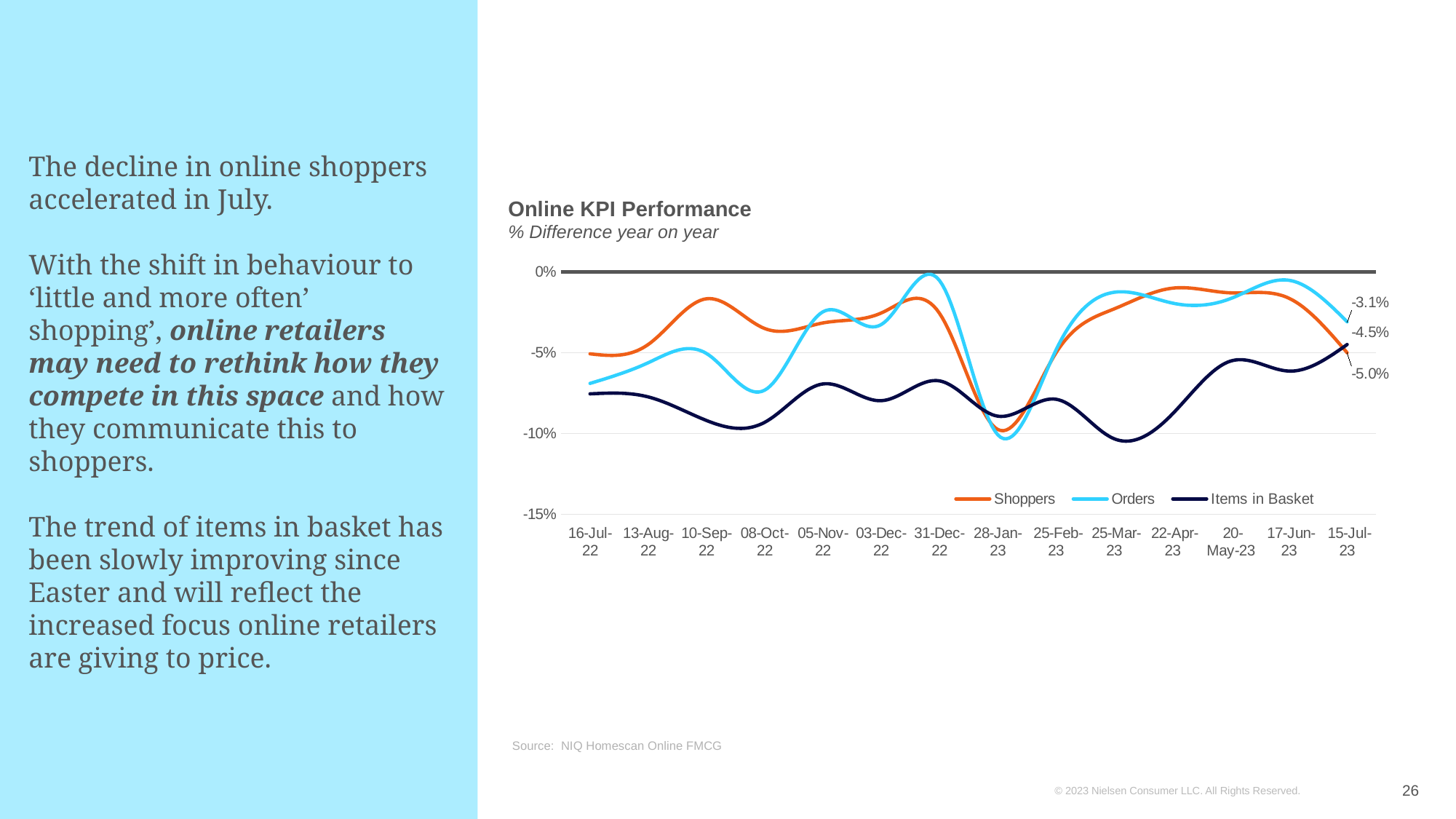
What is the subtitle shown under the chart title 'Online KPI Performance'? % Difference year on year How many series does the legend of the Online KPI Performance chart list? 3 How many dates are shown along the x axis of the Online KPI Performance chart? 14 Which series has the lowest value at 15-Jul-23? Shoppers What kind of chart is shown on the slide? Line chart What is the value for Orders at 15-Jul-23? -3.1% What is the value for Items in Basket at 15-Jul-23? -4.5% Is the value for Items in Basket at 16-Jul-22 greater or less than -5%? less What is the value for Shoppers at 15-Jul-23? -5.0% At 15-Jul-23, which is higher: Orders or Shoppers? Orders At 15-Jul-23, what is the difference between the Orders value and the Shoppers value? 1.9 percentage points Is the value for Shoppers at 10-Sep-22 greater or less than -5%? greater